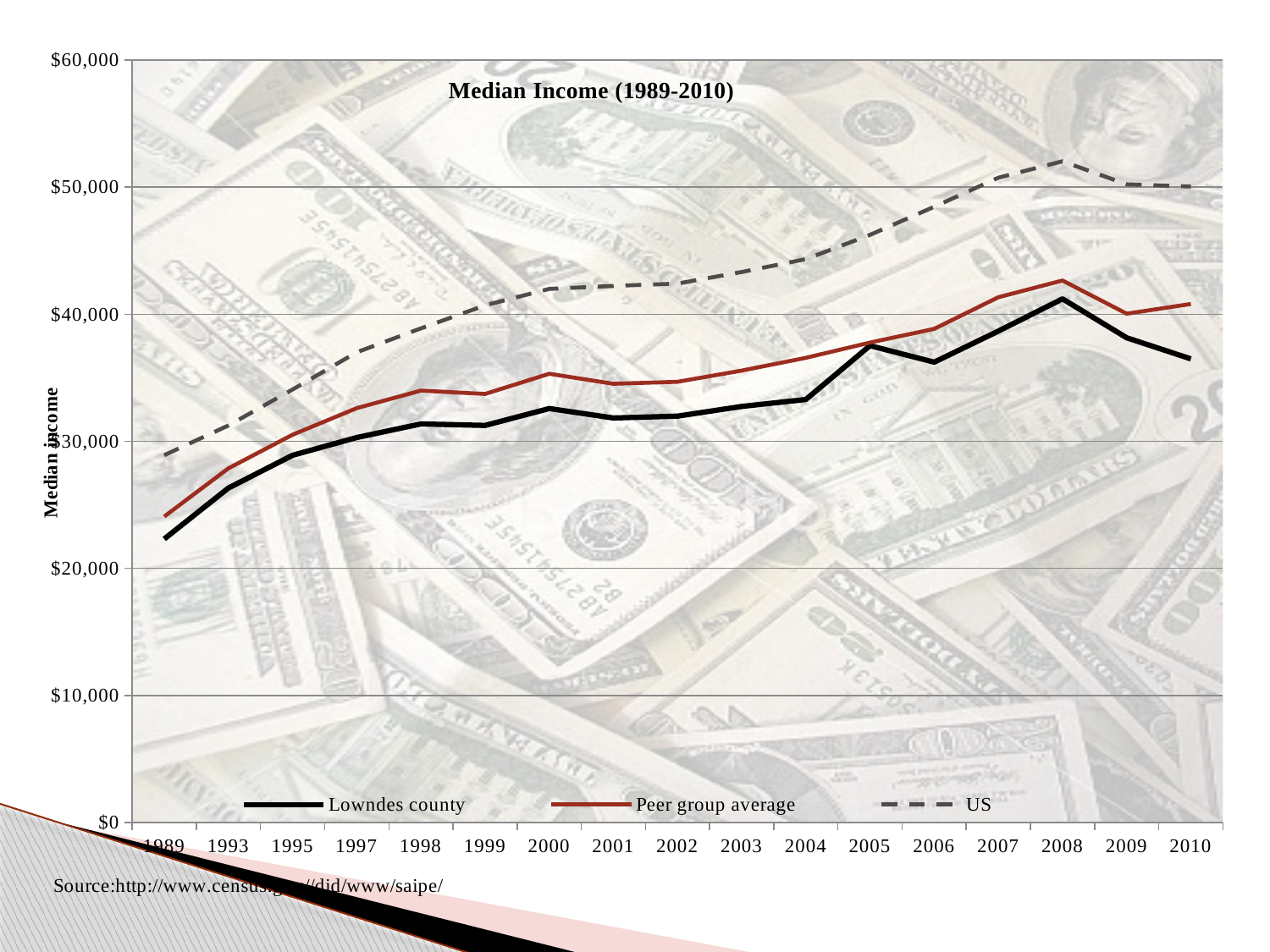
How many series does the legend list? 3 Does the Lowndes county median income rise or fall from 2008 to 2010? fall What type of chart is shown on the slide? line chart Is the value for US in 2008 greater or less than $50,000? greater In which year does the Lowndes county line reach its highest value? 2008 Is the value for Peer group average in 2010 greater or less than $40,000? greater How many years are shown on the x axis? 17 What is the title of the chart? Median Income (1989-2010) Is the value for Lowndes county in 1989 greater or less than $30,000? less In which year is the US median income at its lowest? 1989 Which series is drawn with a dashed line? US In 2010, which is larger: the US median income or the Lowndes county median income? US